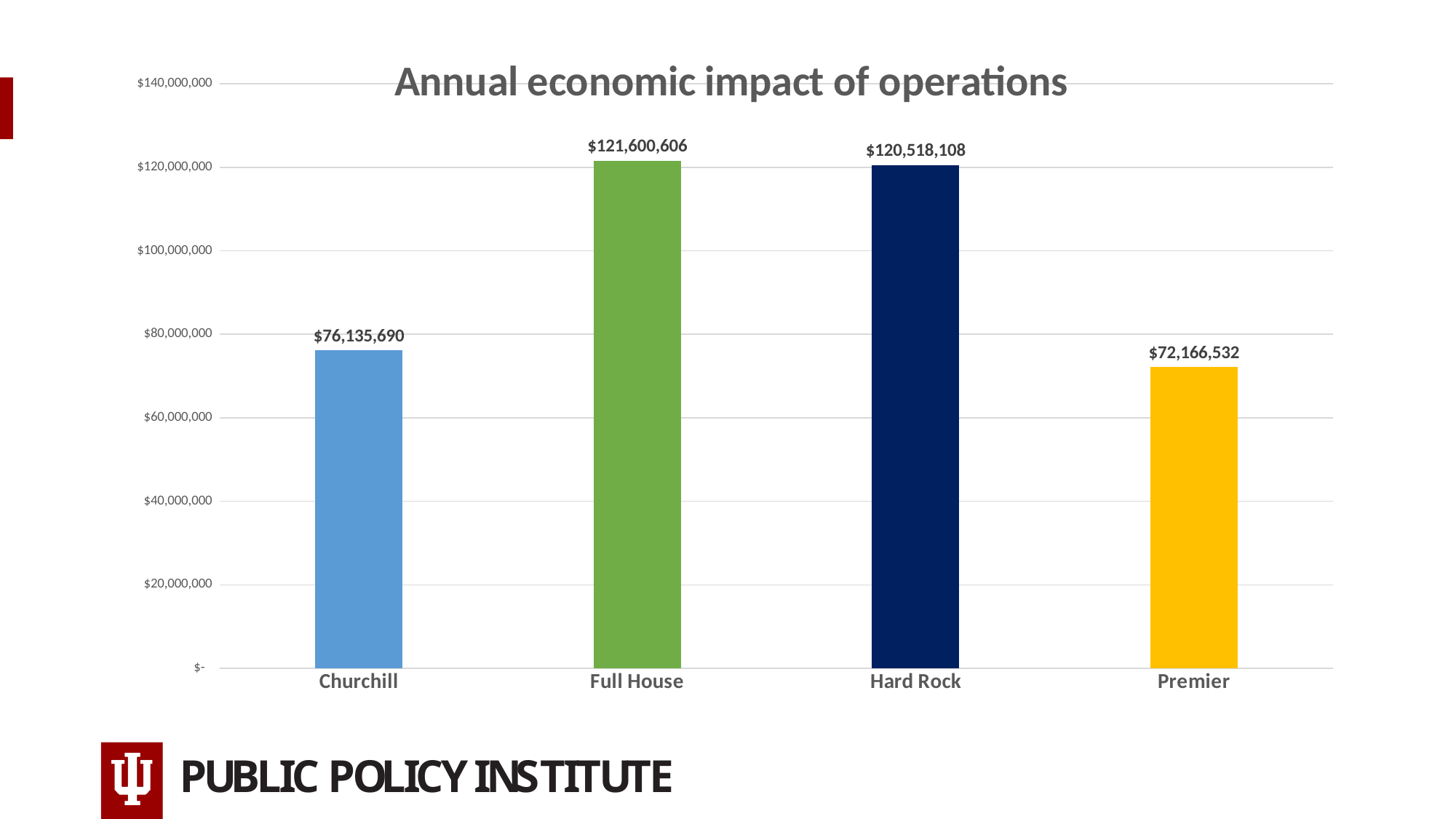
Is the value for Hard Rock greater or less than $100,000,000? greater What is the difference between the annual economic impact of Churchill and Premier? $3,969,158 Which category has the lowest annual economic impact of operations? Premier What is the annual economic impact of operations for Hard Rock? $120,518,108 What is the difference between the annual economic impact of Full House and Hard Rock? $1,082,498 Which has a larger annual economic impact of operations, Churchill or Premier? Churchill What is the annual economic impact of operations for Churchill? $76,135,690 Which category has the highest annual economic impact of operations? Full House What type of chart is shown on the slide? Bar chart How many categories are shown in the chart? 4 What is the annual economic impact of operations for Premier? $72,166,532 What is the annual economic impact of operations for Full House? $121,600,606